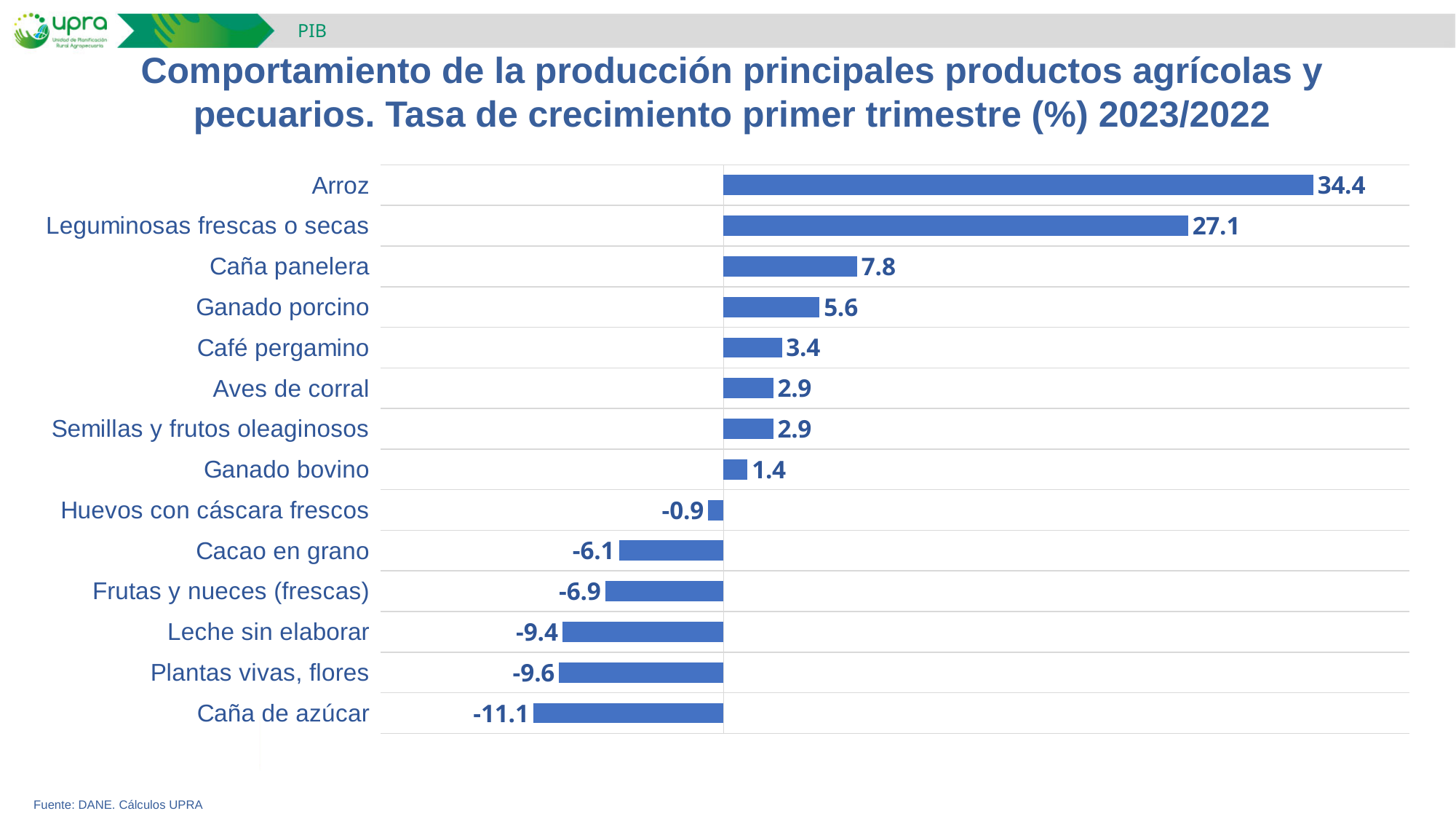
What is the growth rate shown for Arroz? 34.4 What is the difference between the values for Caña panelera and Café pergamino? 4.4 What is the source cited at the bottom of the slide? Fuente: DANE. Cálculos UPRA What is the value shown for Leche sin elaborar? -9.4 Which is larger, the value for Cacao en grano or the value for Frutas y nueces (frescas)? Cacao en grano Which category has the highest growth rate? Arroz What is the value shown for Ganado porcino? 5.6 What is the difference between the values for Arroz and Leguminosas frescas o secas? 7.3 How many categories have a negative growth rate? 6 What kind of chart is shown on the slide? Bar chart How many categories are shown in the chart? 14 Which category has the lowest growth rate? Caña de azúcar